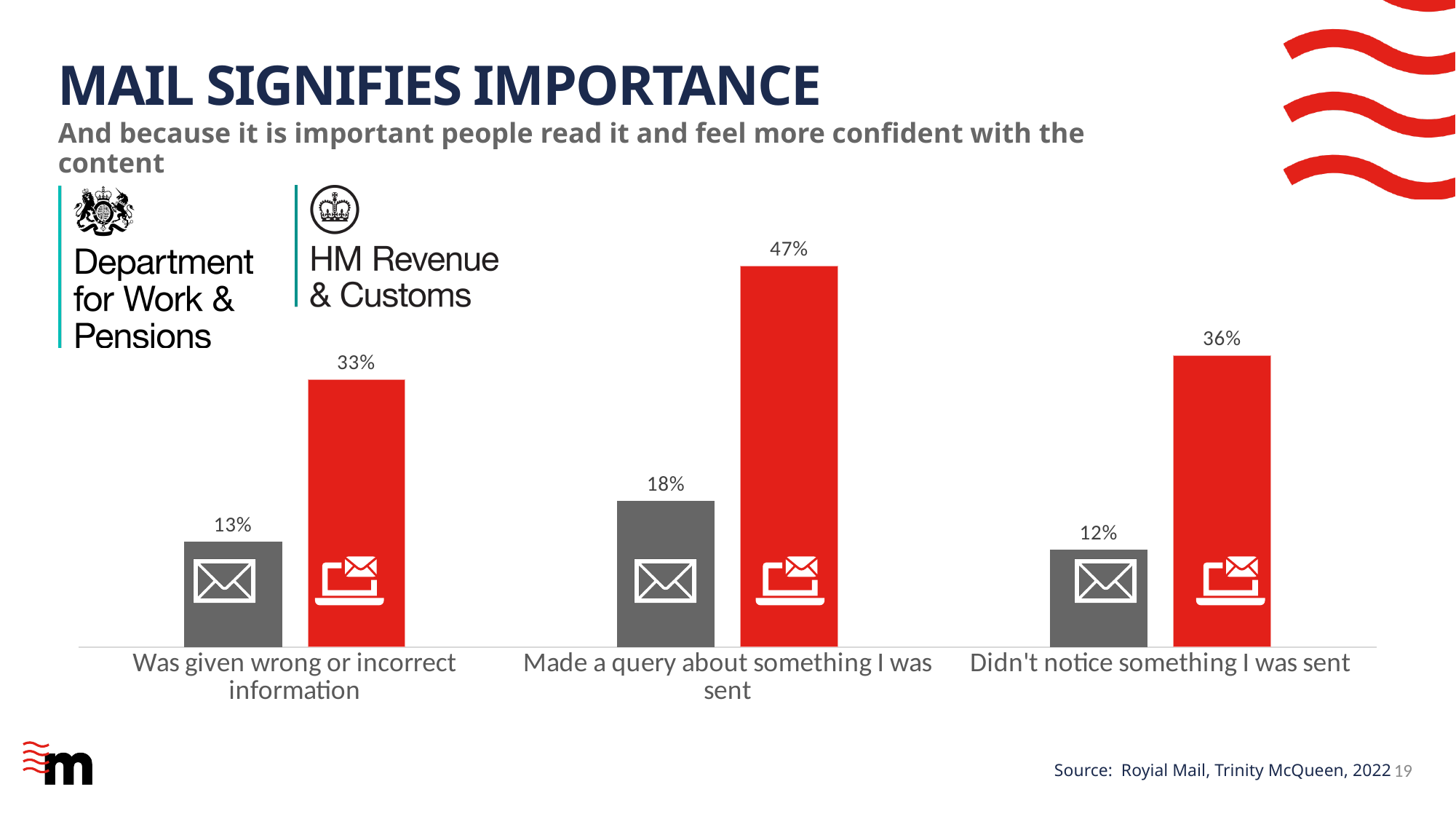
What colour are the bars marked with the envelope icon? Grey What kind of chart is shown on the slide? Bar chart What is the value of the grey bar for "Was given wrong or incorrect information"? 13% What is the value of the red bar for "Didn't notice something I was sent"? 36% Which category has the highest red bar? Made a query about something I was sent What is the value of the red bar for "Made a query about something I was sent"? 47% What is the value of the grey bar for "Made a query about something I was sent"? 18% Which category has the lowest grey bar? Didn't notice something I was sent What is the difference between the red and grey bars for "Was given wrong or incorrect information"? 20% How many categories are shown on the x axis of the chart? 3 Which is larger: the grey bar for "Made a query about something I was sent" or the grey bar for "Didn't notice something I was sent"? Made a query about something I was sent What is the difference between the red and grey bars for "Made a query about something I was sent"? 29%